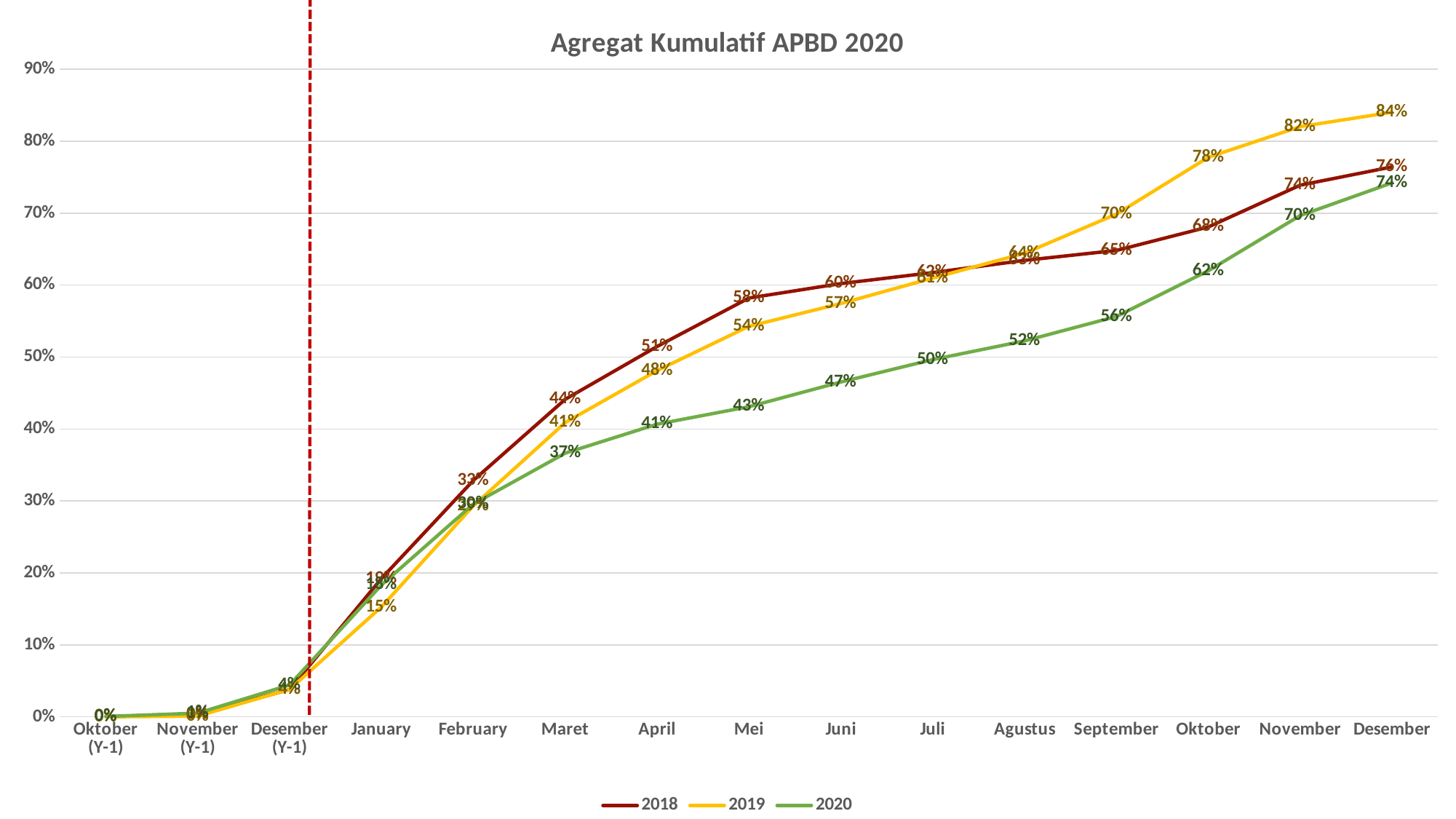
Which series has the highest value in Desember? 2019 What is the difference between the 2019 and 2020 values in Desember? 10% What is the value for 2020 in Oktober? 62% How many categories are shown on the x axis? 15 What is the title of the chart? Agregat Kumulatif APBD 2020 Which series has the lowest value in September? 2020 What is the value for 2020 in Maret? 37% What is the value for 2018 in April? 51% What kind of chart is shown on the slide? line chart What is the value for 2019 in Desember? 84% In Mei, which series has the larger value, 2018 or 2019? 2018 How many series does the legend list? 3